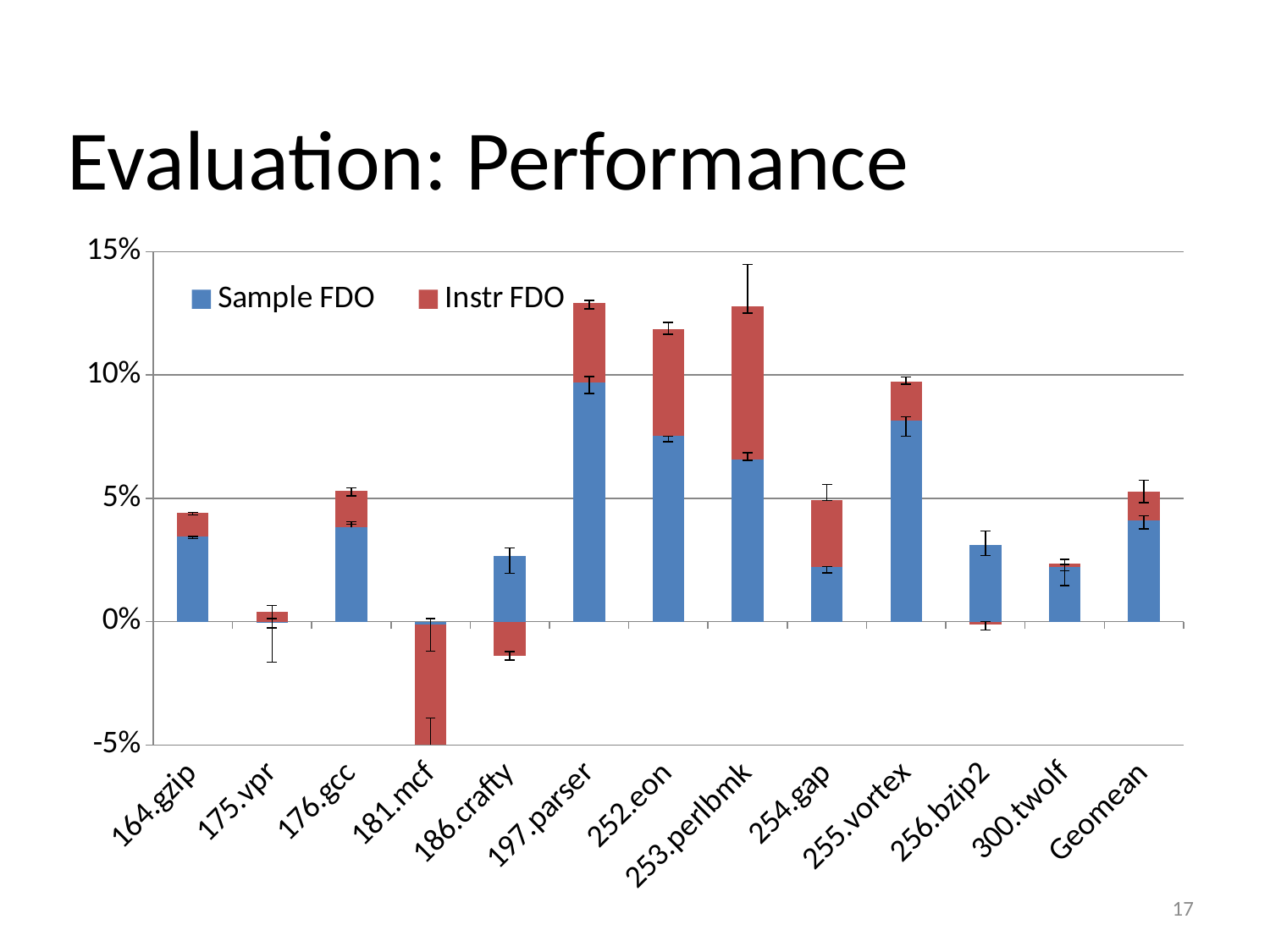
How many series does the legend list? 2 What is the title of the slide containing the chart? Evaluation: Performance Is the Sample FDO value for 197.parser greater or less than 5%? greater Which category has the lowest Instr FDO value? 181.mcf Which has the larger Instr FDO value, 254.gap or 164.gzip? 254.gap Which category has the highest Sample FDO value? 197.parser Which has the larger Sample FDO value, 252.eon or 253.perlbmk? 252.eon Is the Sample FDO value for 164.gzip greater or less than 5%? less Which series does the blue colour represent? Sample FDO What kind of chart is shown on the slide? bar chart How many categories are shown along the x axis? 13 Is the Instr FDO value for 181.mcf greater or less than 0%? less